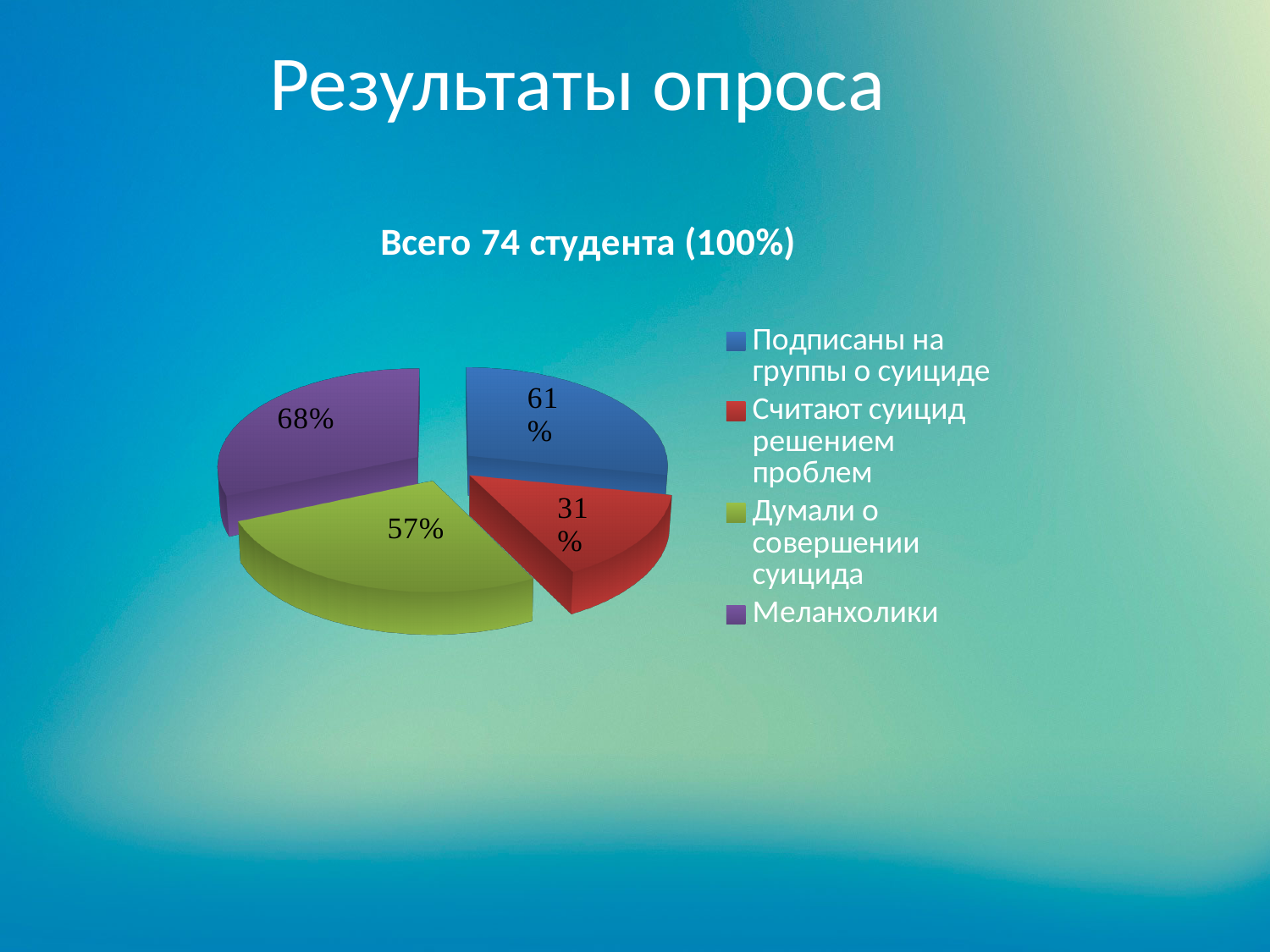
What value is shown for the slice "Думали о совершении суицида"? 57% Which colour is used for the slice "Думали о совершении суицида"? Green Which slice has the highest value? Меланхолики What is the title of the chart? Всего 74 студента (100%) What value is shown for the slice "Меланхолики"? 68% How many slices does the pie chart have? 4 What kind of chart is shown on the slide? Pie chart What is the difference between the values for "Меланхолики" and "Считают суицид решением проблем"? 37 percentage points What value is shown for the slice "Считают суицид решением проблем"? 31% How many entries does the legend list? 4 What value is shown for the slice "Подписаны на группы о суициде"? 61% Which slice has the lowest value? Считают суицид решением проблем